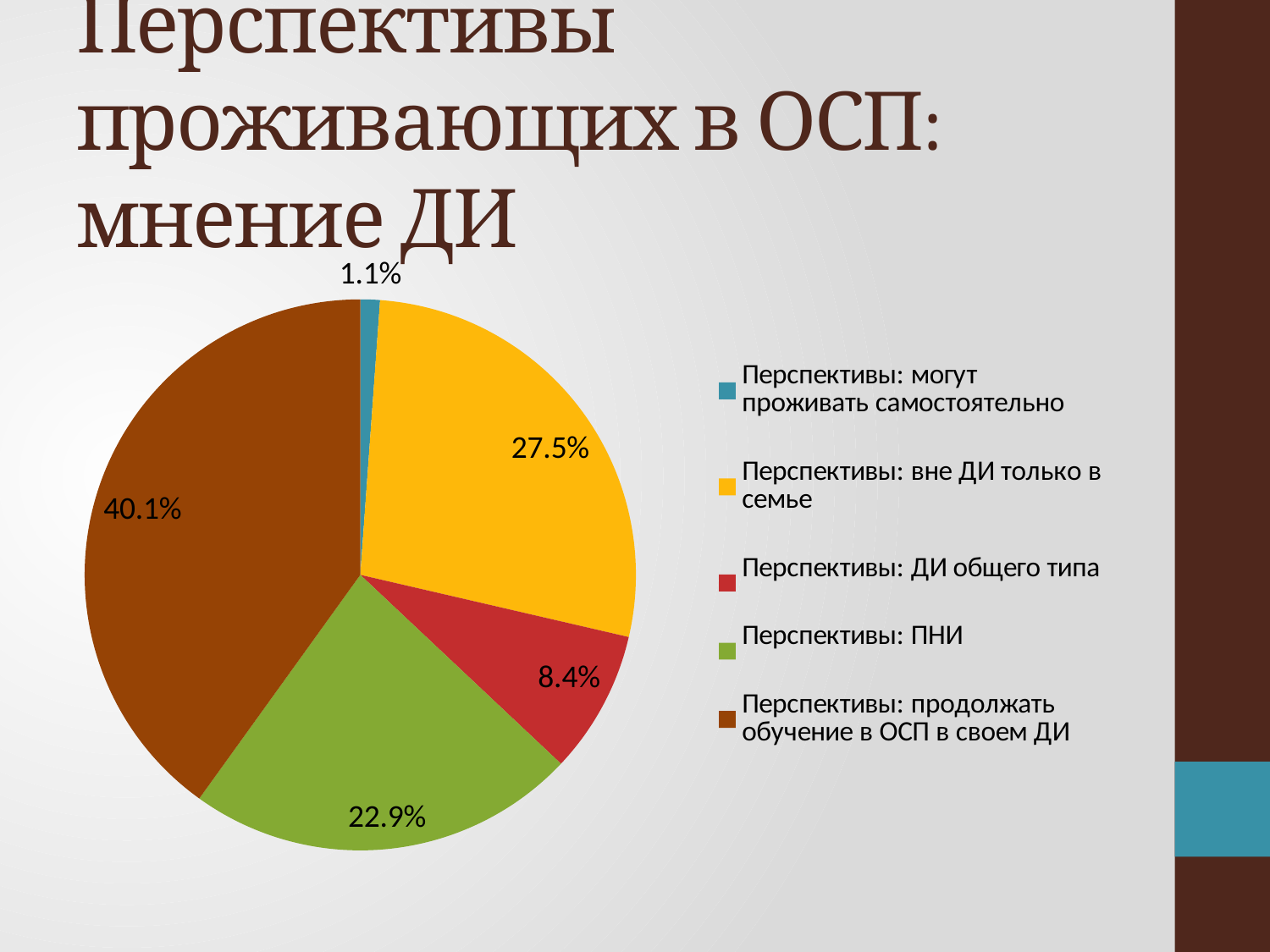
What share of the pie is "Перспективы: продолжать обучение в ОСП в своем ДИ"? 40.1% What kind of chart is shown on the slide? pie chart How many slices does the pie chart have? 5 Which is larger: the value for "Перспективы: ДИ общего типа" or the value for "Перспективы: ПНИ"? Перспективы: ПНИ What is the value for "Перспективы: ПНИ"? 22.9% What is the value for "Перспективы: вне ДИ только в семье"? 27.5% Which category has the largest slice of the pie? Перспективы: продолжать обучение в ОСП в своем ДИ How many entries does the legend list? 5 What colour is the slice for "Перспективы: ПНИ"? green Which category has the smallest slice of the pie? Перспективы: могут проживать самостоятельно What is the difference between the values for "Перспективы: вне ДИ только в семье" and "Перспективы: ПНИ"? 4.6% What is the value for "Перспективы: ДИ общего типа"? 8.4%